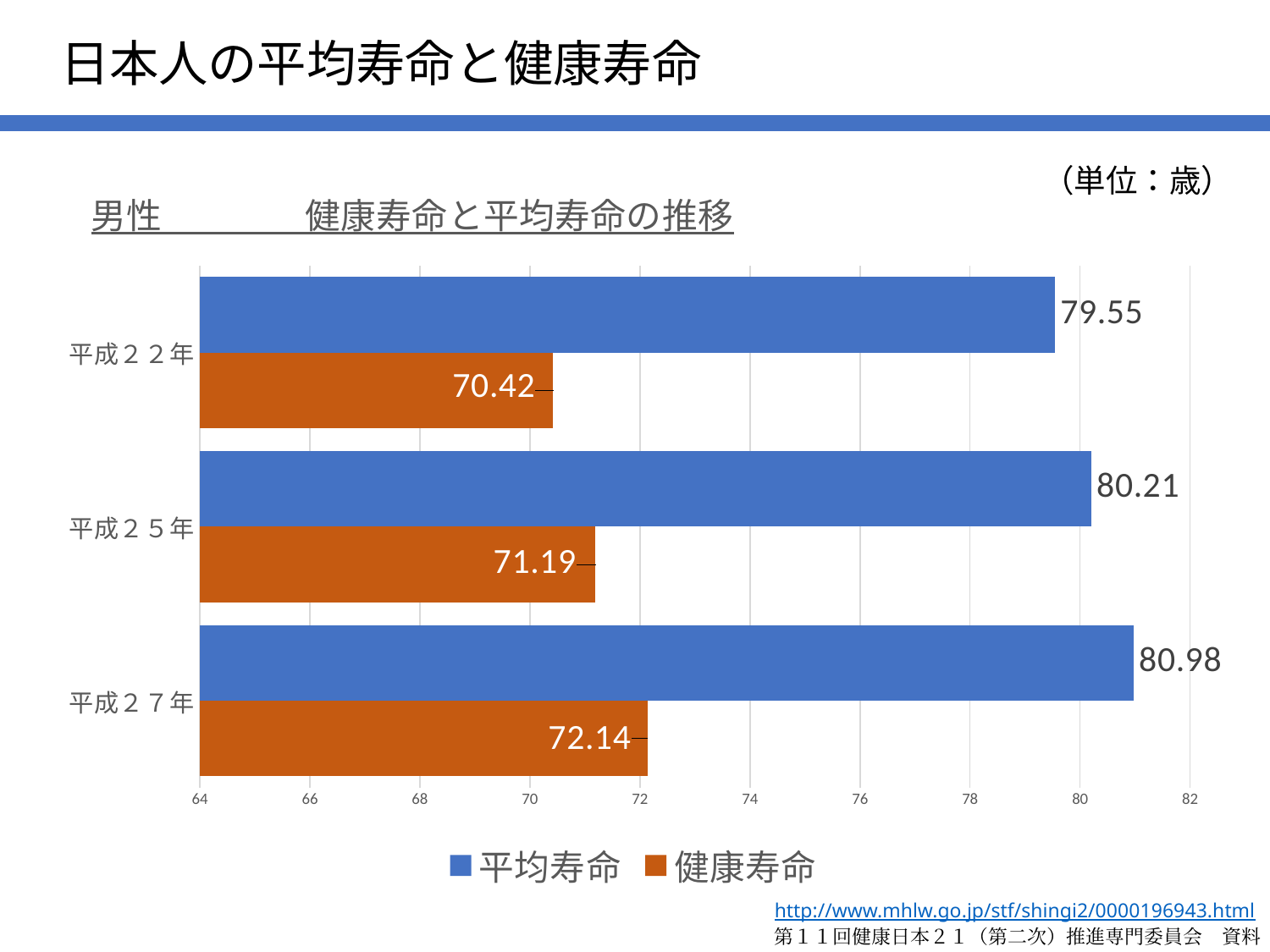
Which year has the lowest 健康寿命? 平成２２年 Which is larger, the 健康寿命 for 平成２７年 or the 健康寿命 for 平成２５年? 平成２７年 How many series does the legend list? 2 What is the 平均寿命 value for 平成２７年? 80.98 Which year has the highest 平均寿命? 平成２７年 What kind of chart is shown on the slide? bar chart What is the difference between 平均寿命 and 健康寿命 in 平成２７年? 8.84 What is the 健康寿命 value for 平成２２年? 70.42 How many years (categories) are shown on the chart? 3 What is the difference between the 平均寿命 values for 平成２５年 and 平成２２年? 0.66 What is the 健康寿命 value for 平成２５年? 71.19 Which colour represents 健康寿命 in the chart? orange